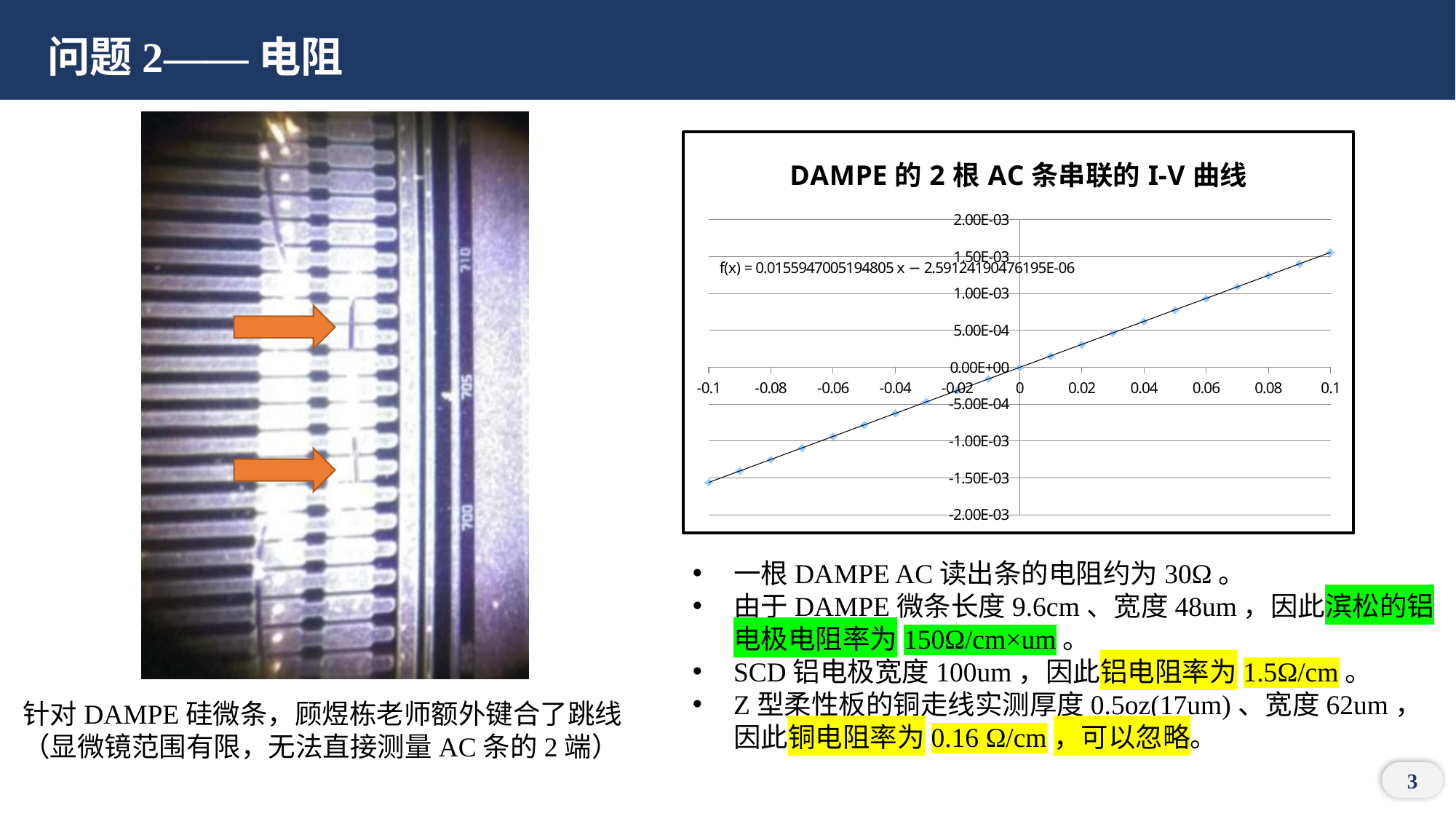
At which x value is the plotted y value lowest? -0.1 At which x value is the plotted y value highest? 0.1 What is the title of the chart on the slide? DAMPE 的 2 根 AC 条串联的 I-V 曲线 How many data points are plotted on the chart? 21 Is the plotted value at x = 0.05 greater or less than 1.00E-03? less What is the fitted trendline equation shown on the chart? f(x) = 0.0155947005194805 x − 2.59124190476195E-06 What kind of chart is shown on the slide? scatter chart with a linear trendline Is the plotted value at x = 0.05 greater or less than 5.00E-04? greater Is the plotted value at x = 0.08 greater or less than 1.00E-03? greater Which has the larger plotted y value, x = 0.06 or x = 0.02? 0.06 Do the plotted values rise or fall as x increases from -0.1 to 0.1? rise